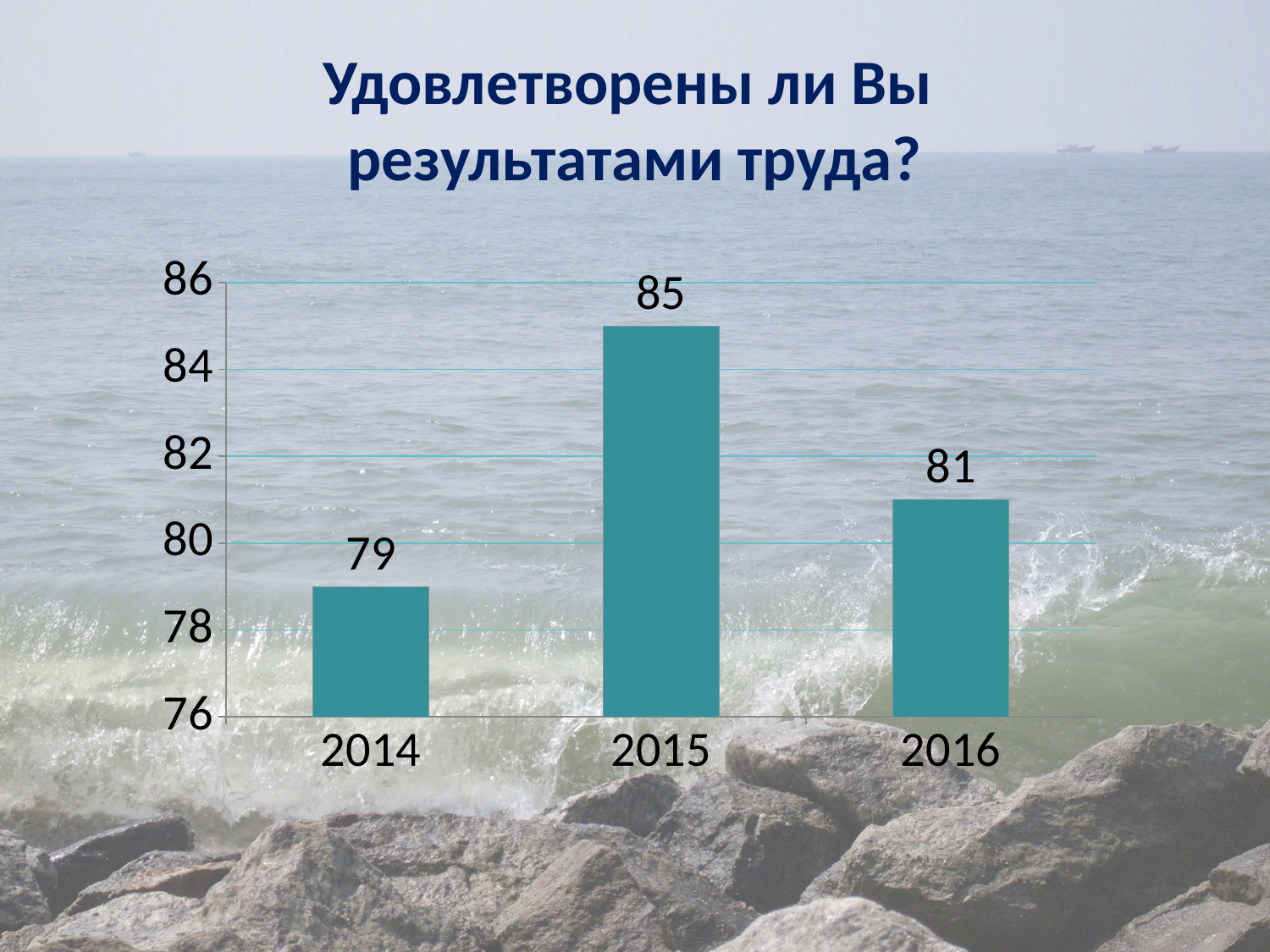
What kind of chart is shown on the slide? bar chart Which year has the lowest value? 2014 What is the difference between the values for 2015 and 2016? 4 What is the difference between the values for 2015 and 2014? 6 What is the value for 2016? 81 What is the title of the slide? Удовлетворены ли Вы результатами труда? Is the value for 2014 greater or less than 80? less Which year has the highest value? 2015 How many years are shown on the chart? 3 Which is larger, the value for 2016 or the value for 2014? 2016 What is the value for 2014? 79 What is the value for 2015? 85